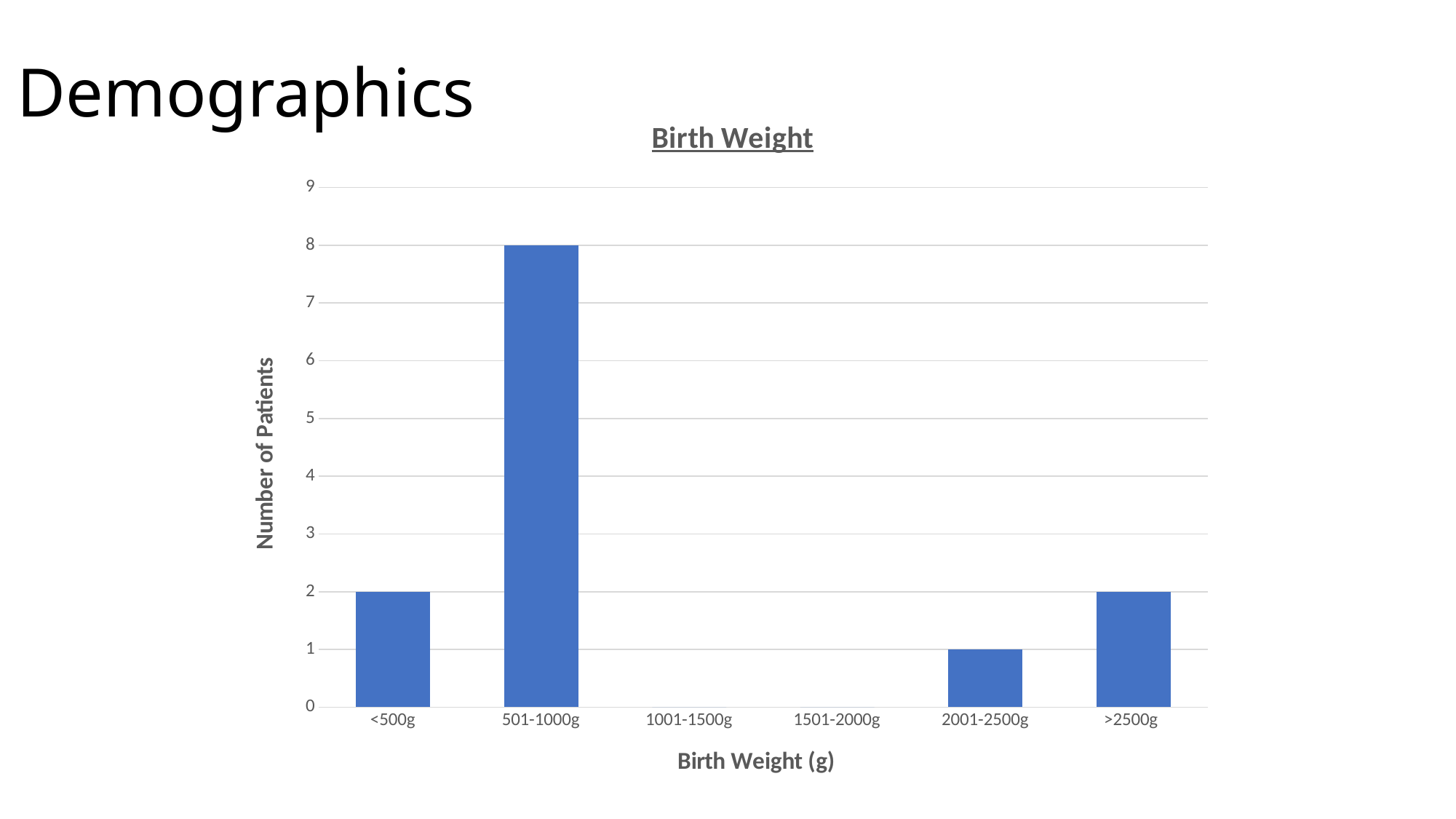
How many patients are in the >2500g category? 2 Is the number of patients in the 501-1000g category greater or less than 5? greater What is the title of the chart? Birth Weight What type of chart is shown on the slide? bar chart Which birth weight category has the highest number of patients? 501-1000g How many patients are in the 2001-2500g category? 1 How many patients are in the <500g category? 2 How many birth weight categories are shown on the x axis? 6 Which has more patients, the 2001-2500g category or the >2500g category? >2500g What is the difference in number of patients between the 501-1000g and <500g categories? 6 How many patients are in the 501-1000g category? 8 What is the label of the y axis? Number of Patients